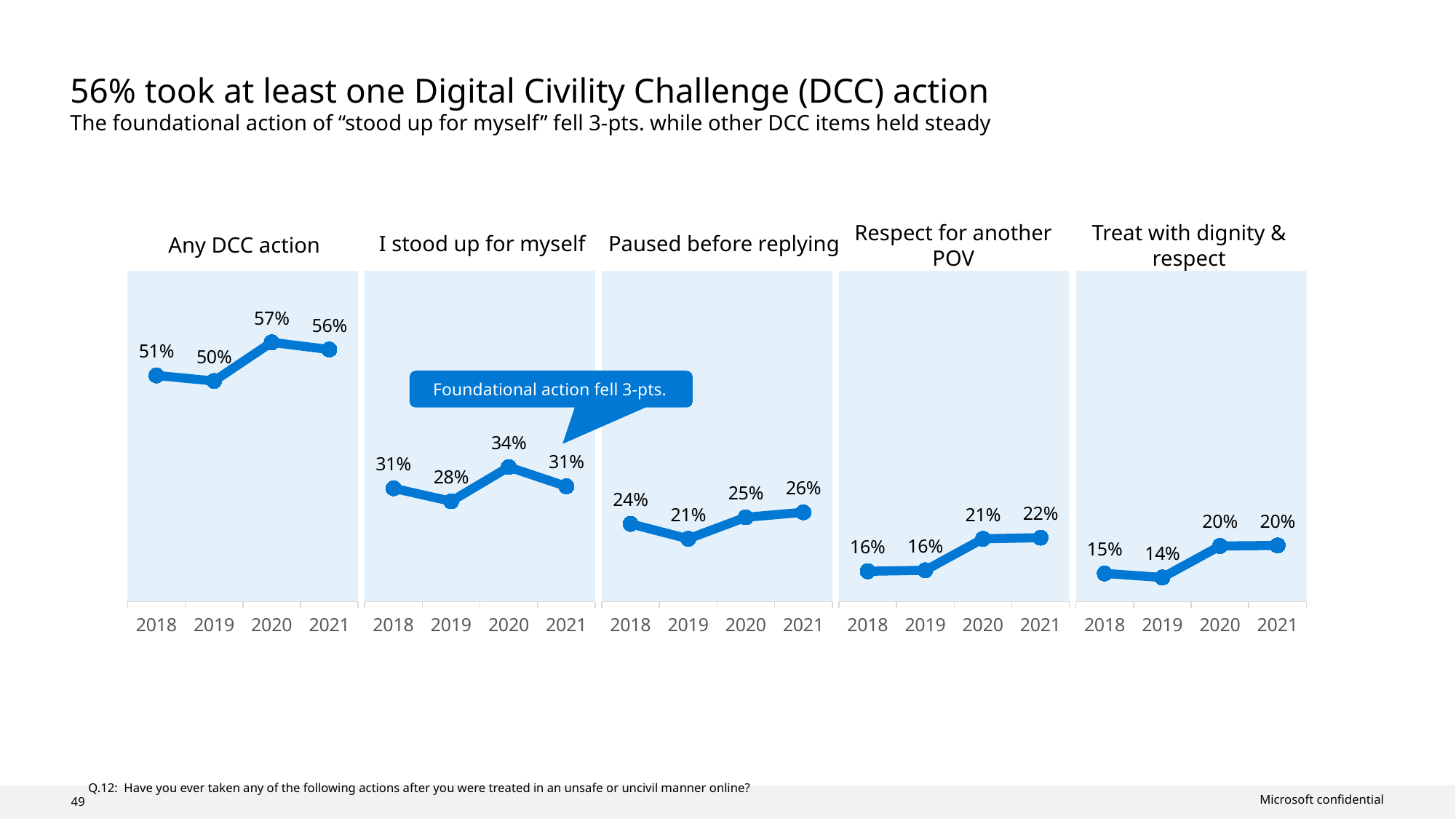
In the 'I stood up for myself' chart, what is the value for 2021? 31% In the 'I stood up for myself' chart, what is the difference between the 2020 and 2021 values? 3 percentage points How many years are plotted in the 'Paused before replying' chart? 4 In the 'Respect for another POV' chart, which year has the highest value? 2021 What does the callout box on the 'I stood up for myself' chart say? Foundational action fell 3-pts. In the 'Treat with dignity & respect' chart, what is the difference between the 2018 and 2019 values? 1 percentage point In the 'Any DCC action' chart, what is the value for 2020? 57% What kind of chart is used for 'Respect for another POV'? Line chart In the 'Treat with dignity & respect' chart, which year has the lowest value? 2019 In the 'Paused before replying' chart, do values rise or fall from 2019 to 2021? Rise In the 'Any DCC action' chart, which is larger, the value for 2018 or the value for 2019? 2018 In the 'Paused before replying' chart, what is the value for 2019? 21%